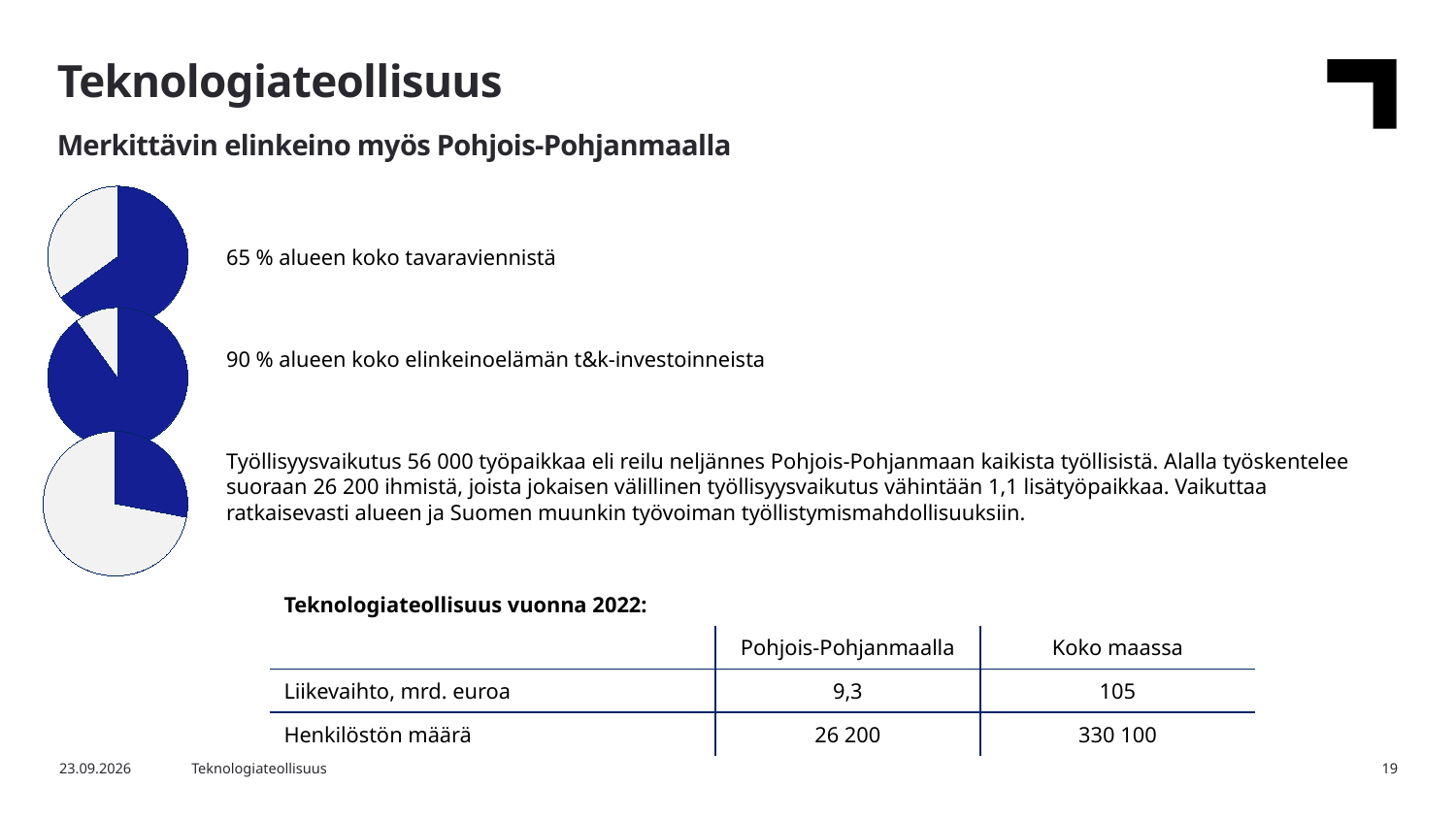
In the middle pie chart, what share of the region's business R&D investments (t&k-investoinnit) does the blue slice represent? 90 % What is the difference in percentage points between the shares shown by the middle pie chart (90 %) and the top pie chart (65 %)? 25 percentage points Is the blue slice in the top pie chart larger or smaller than the blue slice in the middle pie chart? Smaller Is the blue slice in the bottom pie chart larger or smaller than the blue slice in the top pie chart? Smaller What colour is used for the highlighted slice in each pie chart? Blue Does the bottom pie chart's blue slice represent more or less than half of the pie? Less What kind of charts are shown on the left side of the slide? Pie charts Which pie chart has the largest blue slice: the top, middle or bottom one? Middle How many pie charts are shown on the slide? 3 In the top pie chart, what share of the region's total goods exports (tavaravienti) does the blue slice represent? 65 % Which pie chart has the smallest blue slice: the top, middle or bottom one? Bottom